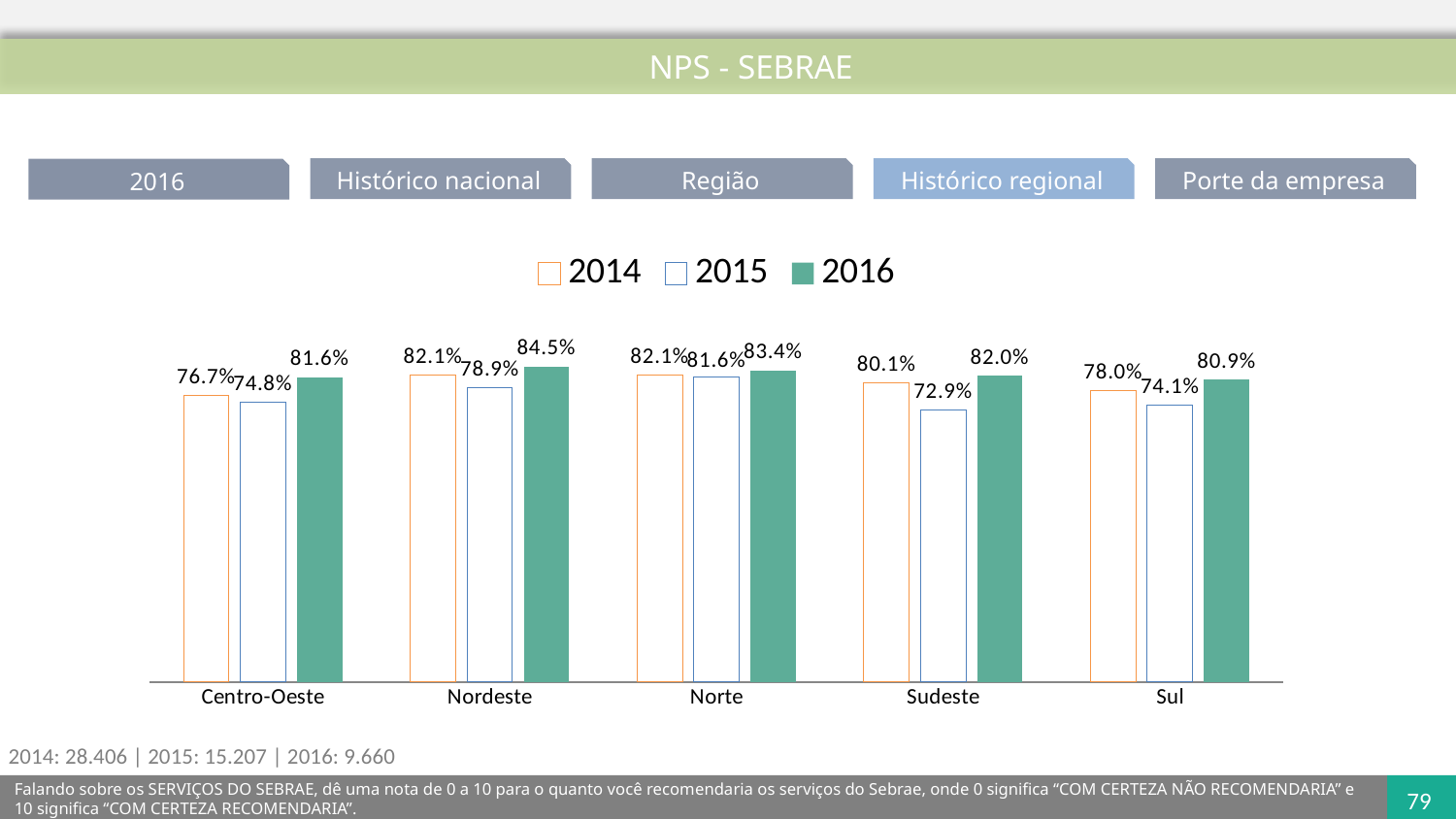
Which series is drawn with solid green bars? 2016 What is the 2016 value for Nordeste? 84.5% How many regions are shown on the x axis? 5 What is the 2014 value for Sul? 78.0% Which region has the highest 2016 value? Nordeste What is the difference between the 2016 and 2015 values for Centro-Oeste? 6.8% Which region has the lowest 2015 value? Sudeste What is the 2015 value for Sudeste? 72.9% What kind of chart is shown on the slide? Bar chart How many series does the legend list? 3 Which is larger for Norte: the 2014 value or the 2015 value? 2014 What is the difference between the 2014 and 2015 values for Sudeste? 7.2%